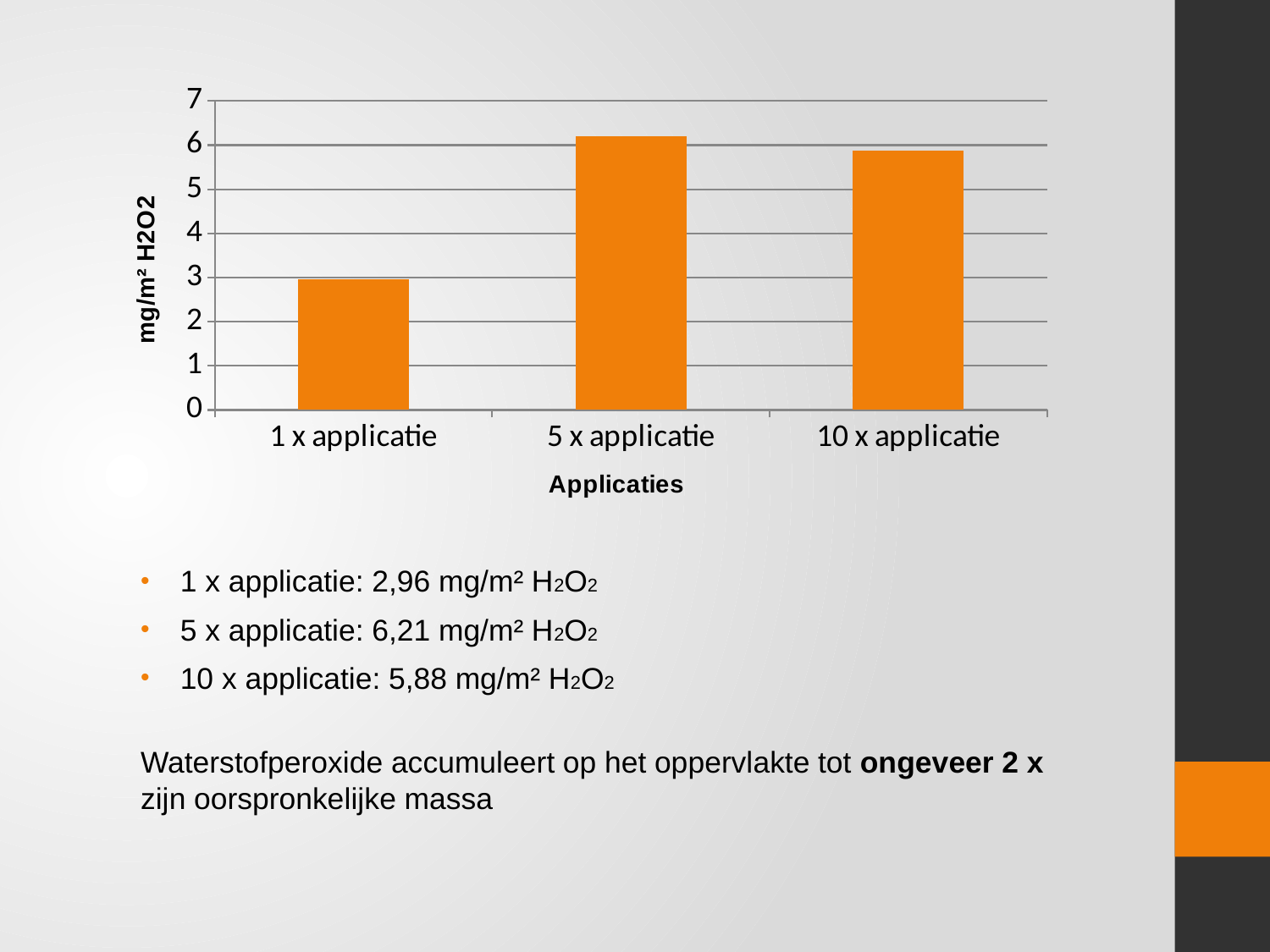
Which is larger, the value for 5 x applicatie or 10 x applicatie? 5 x applicatie Is the value for 1 x applicatie greater or less than 3? less What is the difference between the values for 5 x applicatie and 10 x applicatie? 0,33 mg/m² H₂O₂ What is the label of the y axis? mg/m² H2O2 Which category has the highest value? 5 x applicatie What is the value for 1 x applicatie? 2,96 mg/m² H₂O₂ What is the difference between the values for 5 x applicatie and 1 x applicatie? 3,25 mg/m² H₂O₂ How many categories are shown on the x axis? 3 What kind of chart is shown on the slide? bar chart What is the value for 5 x applicatie? 6,21 mg/m² H₂O₂ What is the value for 10 x applicatie? 5,88 mg/m² H₂O₂ Which category has the lowest value? 1 x applicatie